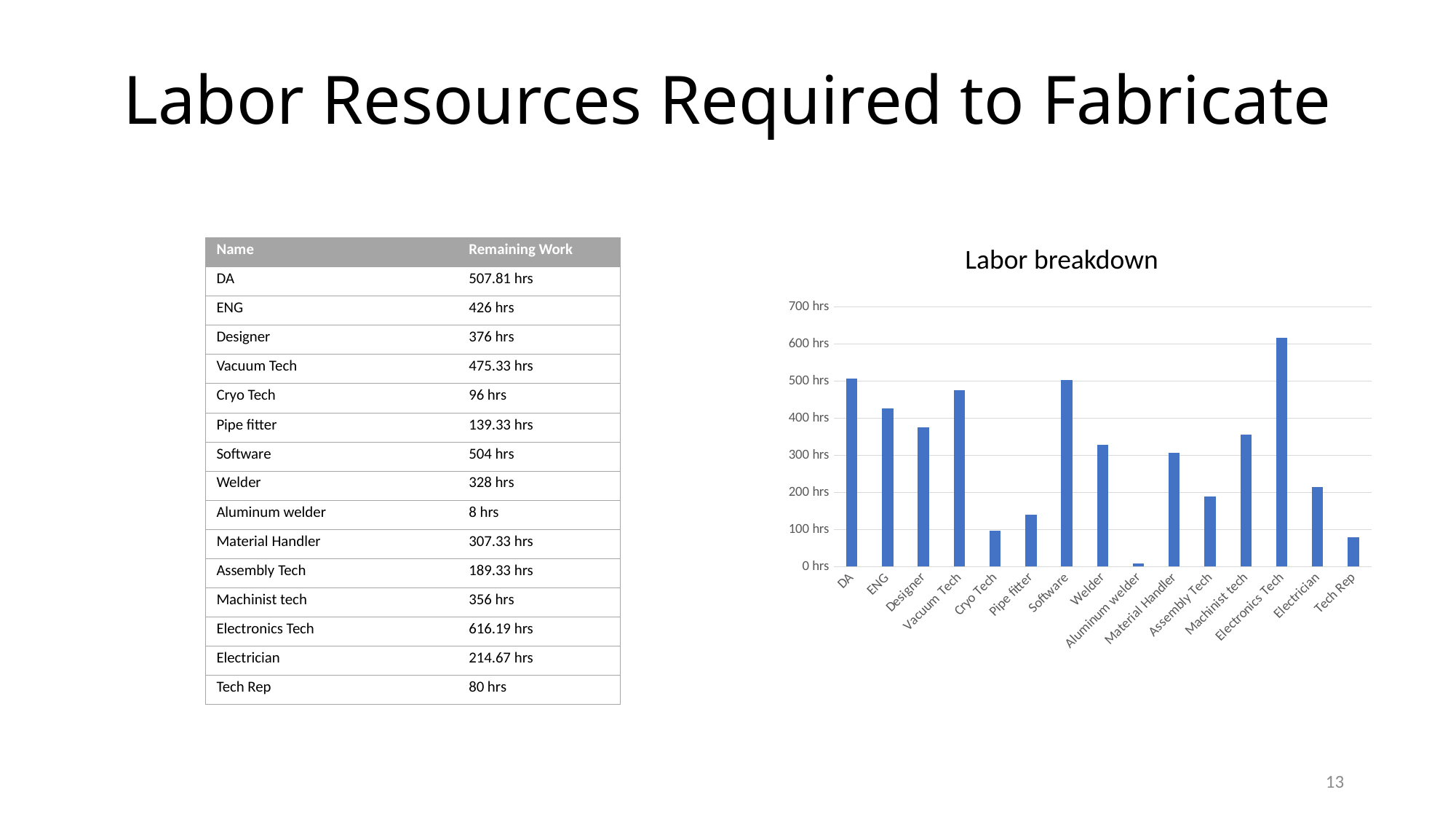
How many categories are plotted in the Labor breakdown chart? 15 Which category has the lowest value in the Labor breakdown chart? Aluminum welder Is the value for Electronics Tech in the Labor breakdown chart greater or less than 600 hrs? greater What type of chart is shown on the slide? bar chart Which category has the highest value in the Labor breakdown chart? Electronics Tech In the Labor breakdown chart, which is larger, the value for ENG or the value for Designer? ENG According to the slide, what is the remaining work for Electronics Tech? 616.19 hrs Is the value for Welder in the Labor breakdown chart greater or less than 300 hrs? greater According to the slide, what is the remaining work for Tech Rep? 80 hrs What is the title of the chart? Labor breakdown In the Labor breakdown chart, which is larger, the value for Electrician or the value for Assembly Tech? Electrician